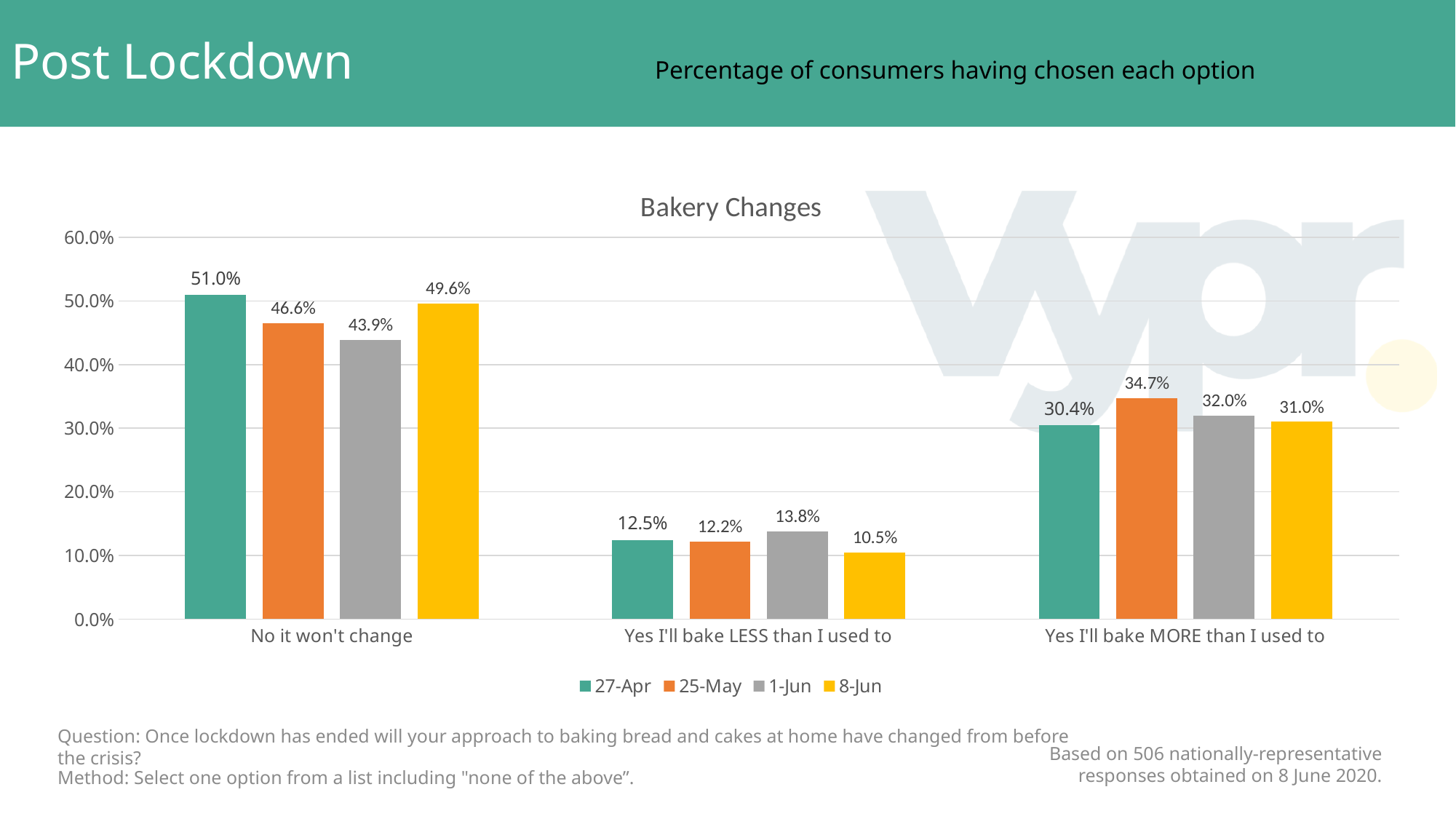
What is the difference between the 27-Apr and 1-Jun values in the 'No it won't change' category? 7.1% Which is larger: the 25-May value or the 8-Jun value for 'Yes I'll bake MORE than I used to'? 25-May What is the value for 27-Apr in the 'No it won't change' category? 51.0% How many series does the legend list? 4 How many categories are shown on the x axis? 3 Which series has the highest value in the 'Yes I'll bake LESS than I used to' category? 1-Jun Which series has the lowest value in the 'No it won't change' category? 1-Jun What kind of chart is shown on the slide? Bar chart What is the title of the chart? Bakery Changes What is the value for 25-May in the 'Yes I'll bake MORE than I used to' category? 34.7% Is the 27-Apr value for 'Yes I'll bake MORE than I used to' greater or less than 40.0%? less What is the value for 8-Jun in the 'Yes I'll bake LESS than I used to' category? 10.5%